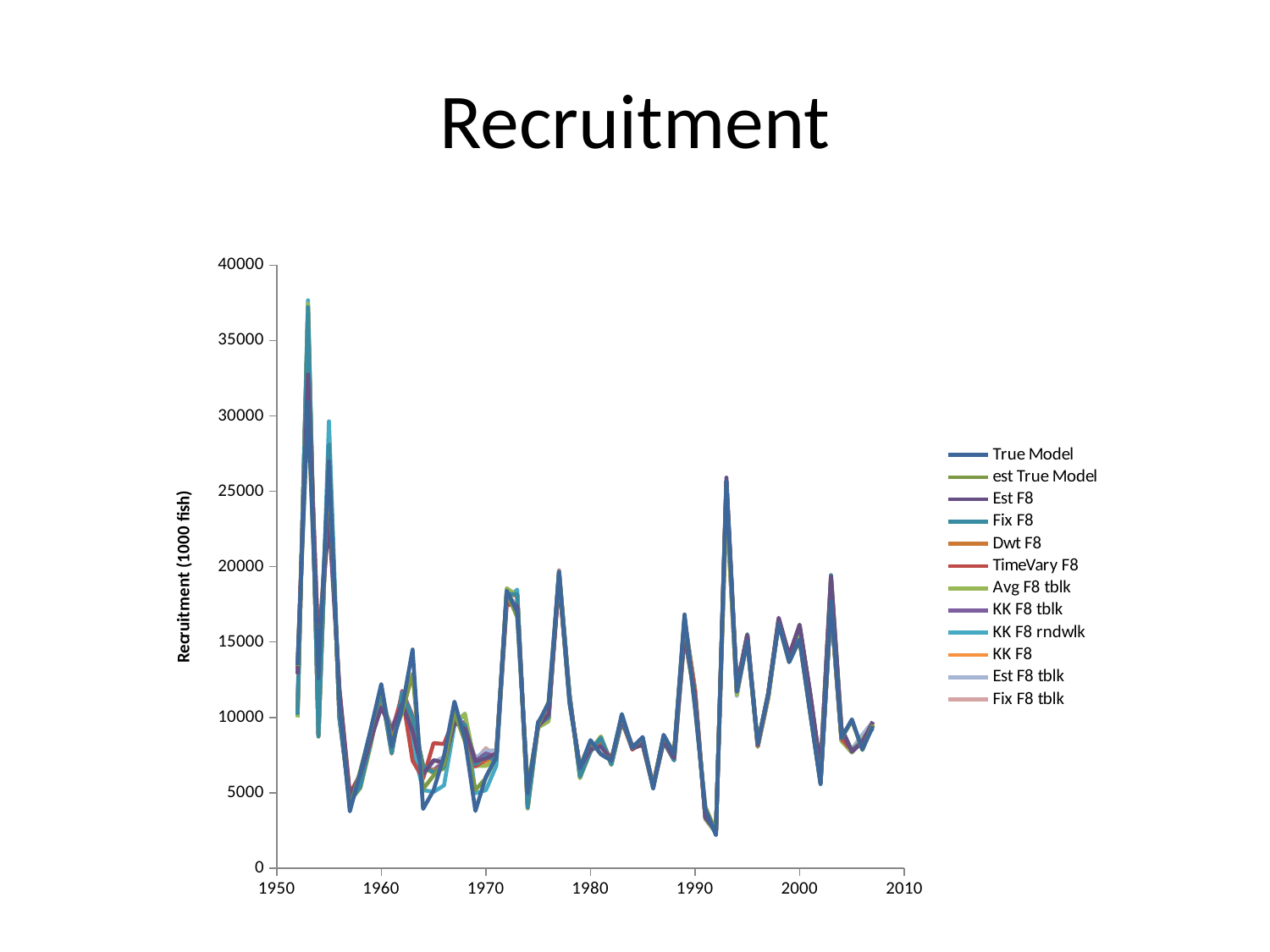
Is the recruitment value around 1992 greater or less than 5000? less In which year does recruitment reach its highest peak? 1953 Which year has the higher recruitment peak, 1953 or 1955? 1953 What kind of chart is shown on the slide? line chart What is the label on the vertical axis? Recruitment (1000 fish) What is the title of the chart? Recruitment Is the recruitment value around 1993 greater or less than 20000? greater Does recruitment rise or fall between 1955 and 1957? fall Is the recruitment value around 1977 greater or less than 15000? greater How many series does the legend list? 12